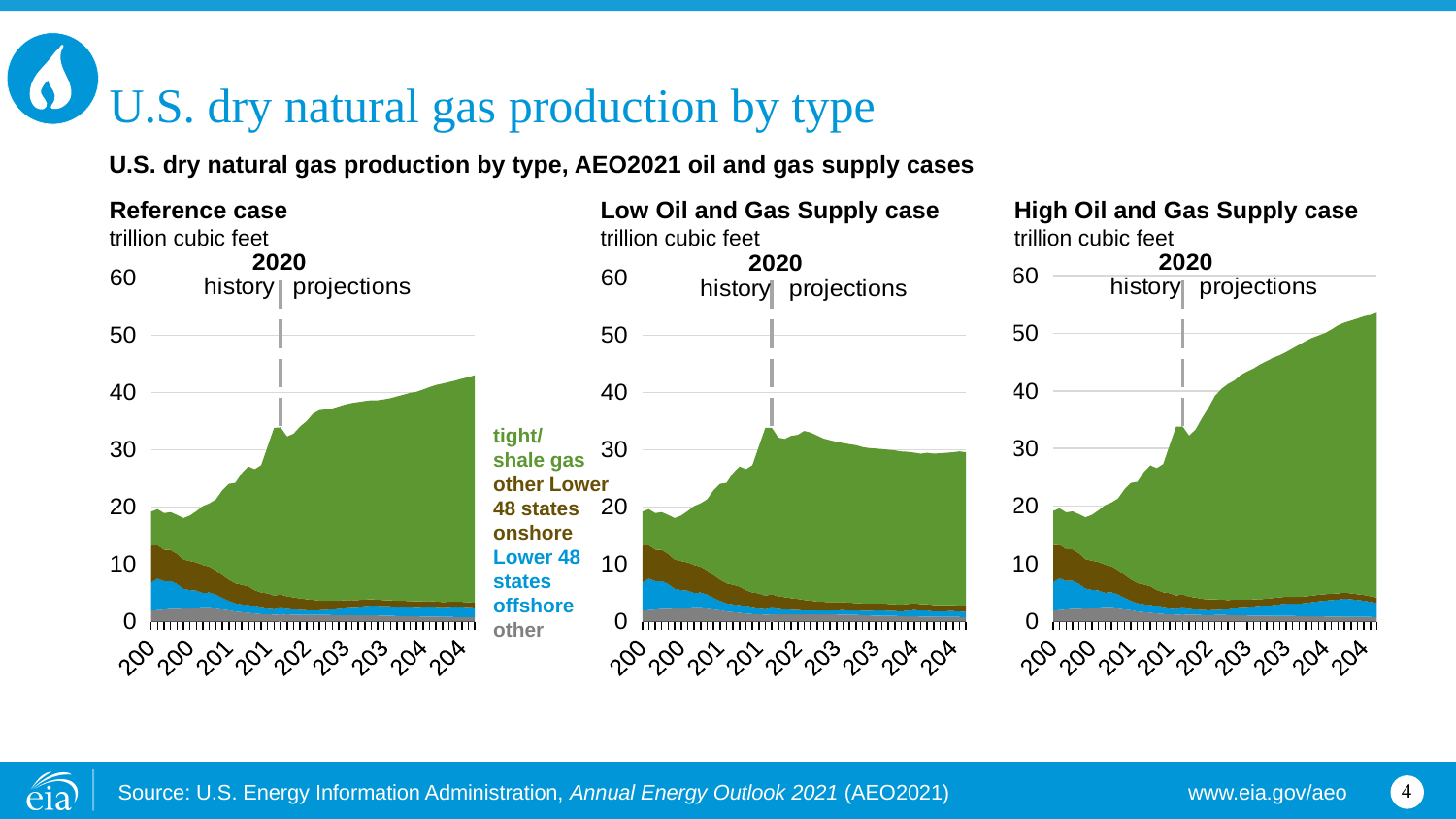
In the Reference case chart, is the total production in 2020 greater or less than 30 trillion cubic feet? greater In the High Oil and Gas Supply case chart, is the total production at the end of the projection period greater or less than 50 trillion cubic feet? greater What unit is shown on the y axis of the three charts? trillion cubic feet In the Reference case chart, is the total production at the end of the projection period greater or less than 40 trillion cubic feet? greater Which of the three cases shows the highest total production at the end of the projection period? High Oil and Gas Supply case Which of the three cases shows the lowest total production at the end of the projection period? Low Oil and Gas Supply case In the Low Oil and Gas Supply case chart, does total production rise or fall from its peak shortly after 2020 to the end of the projection period? fall What kind of chart is used for the Reference case? Stacked area chart Which series accounts for the largest share of production in all three charts? tight/shale gas In the High Oil and Gas Supply case chart, does total production rise or fall over the projection period? rise How many series does the legend list for the charts? 4